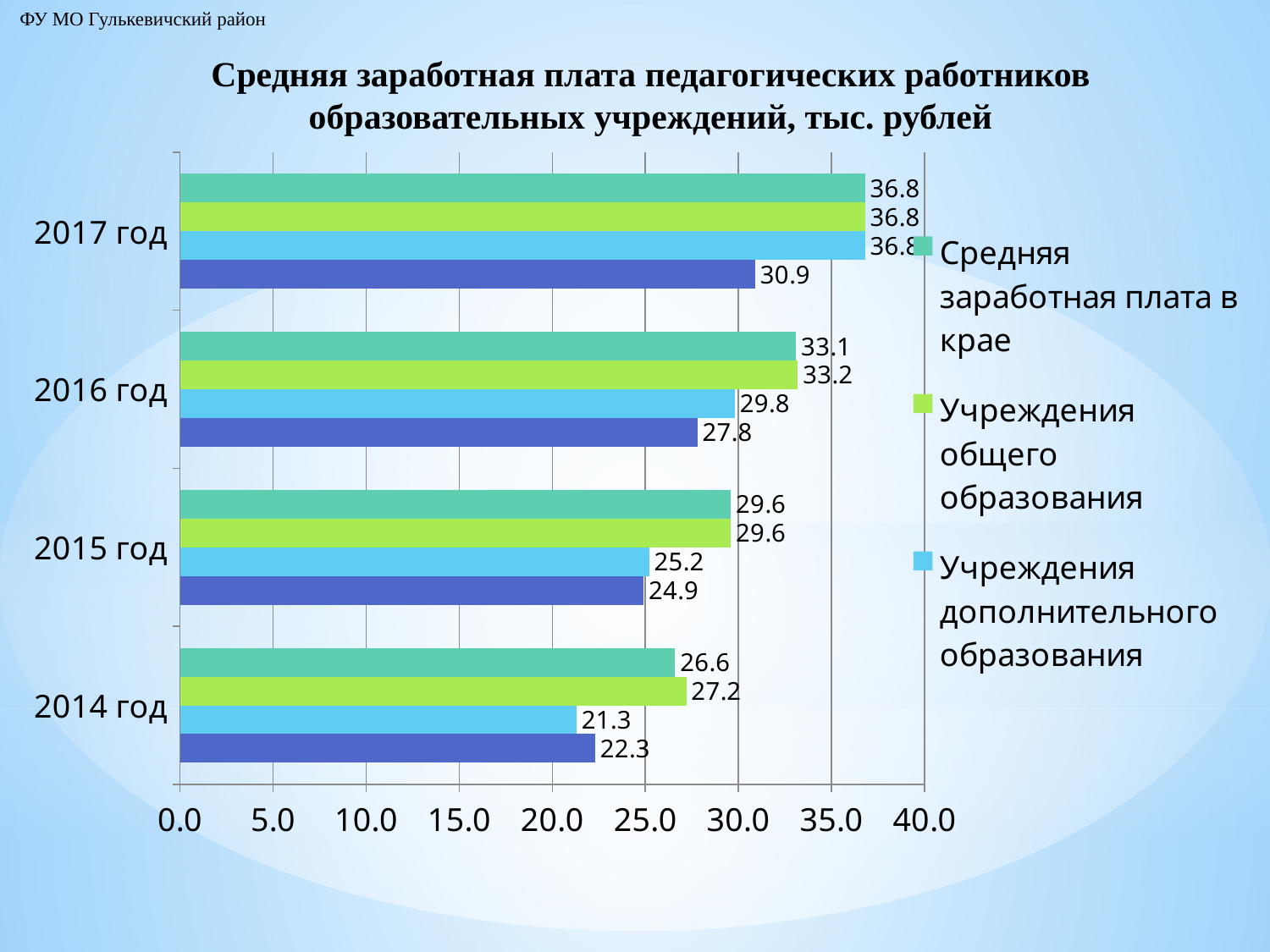
What unit is stated in the chart title? тыс. рублей What kind of chart is shown on the slide? bar chart How many years are shown on the chart? 4 What is the value for Учреждения дополнительного образования in 2015 год? 25.2 In 2014 год, which is larger: Учреждения общего образования or Средняя заработная плата в крае? Учреждения общего образования In which year is the value for Средняя заработная плата в крае the highest? 2017 год What is the value for Учреждения общего образования in 2014 год? 27.2 What is the difference between the Учреждения общего образования values for 2016 год and 2015 год? 3.6 What is the value for Учреждения дополнительного образования in 2016 год? 29.8 What is the value for Средняя заработная плата в крае in 2017 год? 36.8 Do the values for Учреждения дополнительного образования rise or fall from 2014 год to 2017 год? rise In which year is the value for Учреждения дополнительного образования the lowest? 2014 год